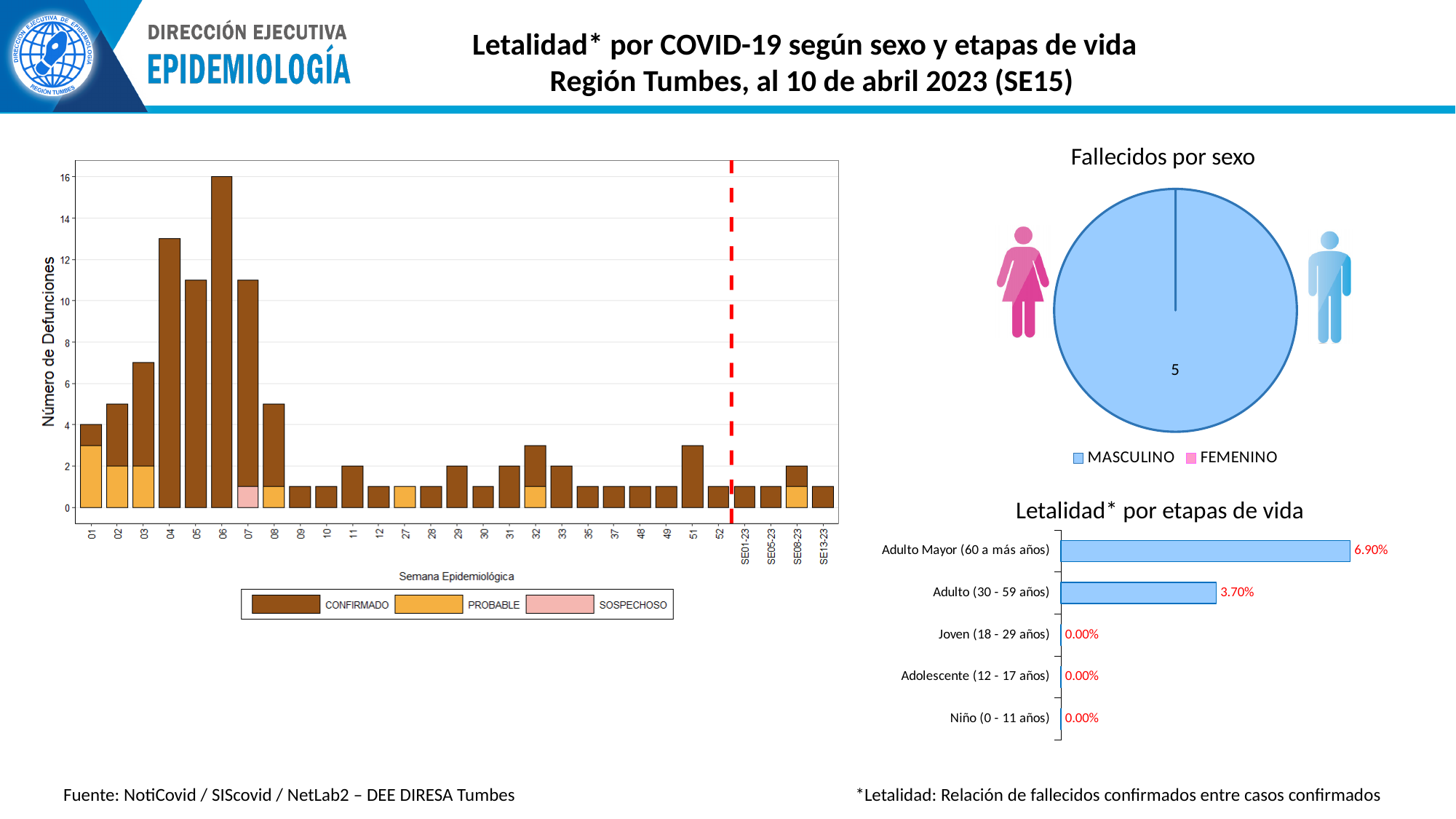
In the 'Fallecidos por sexo' pie chart, how many categories does the legend list? 2 In the 'Número de Defunciones' chart on the left, which epidemiological week has the highest number of deaths? 06 In the 'Fallecidos por sexo' pie chart, which sex accounts for the largest share of deaths? MASCULINO In the 'Letalidad* por etapas de vida' chart, what is the value for Adulto Mayor (60 a más años)? 6.90% In the 'Letalidad* por etapas de vida' chart, what is the value for Adulto (30 - 59 años)? 3.70% In the 'Número de Defunciones' chart on the left, what is the total number of deaths in week 06? 16 In the 'Letalidad* por etapas de vida' chart, how many age-stage categories are shown? 5 In the 'Número de Defunciones' chart on the left, how many series does the legend list? 3 What kind of chart is 'Letalidad* por etapas de vida'? bar chart In the 'Fallecidos por sexo' pie chart, what value is shown for MASCULINO? 5 In the 'Letalidad* por etapas de vida' chart, what is the difference between the values for Adulto Mayor (60 a más años) and Adulto (30 - 59 años)? 3.20% In the 'Número de Defunciones' chart on the left, is the value for week 04 greater or less than 12? greater